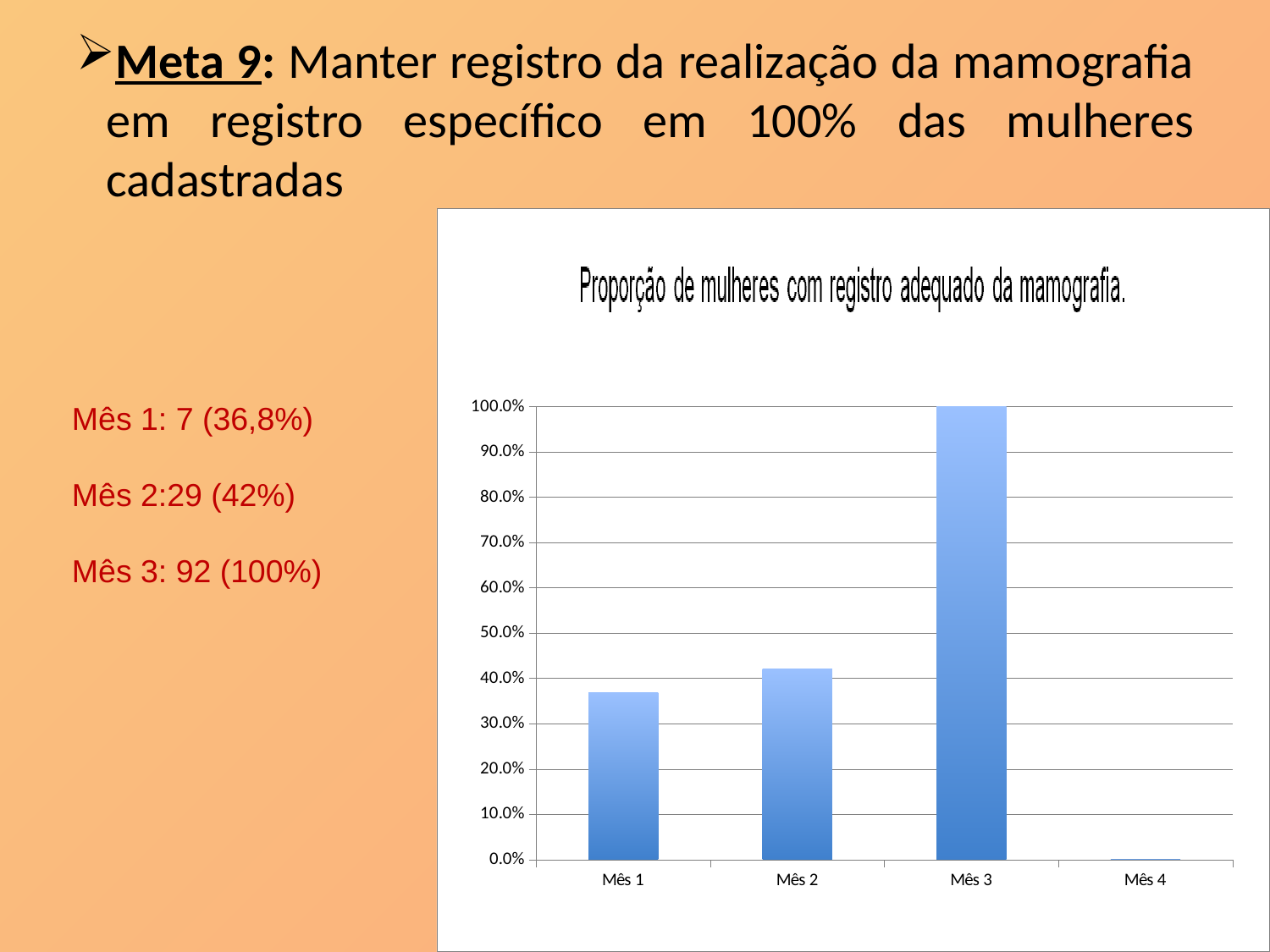
What is the value for Mês 3 in the chart? 100.0% Which is larger, the value for Mês 1 or the value for Mês 2? Mês 2 Is the value for Mês 1 greater or less than 40.0%? less What is the title of the chart? Proporção de mulheres com registro adequado da mamografia. Is the value for Mês 2 greater or less than 40.0%? greater What kind of chart is shown on the slide? bar chart Is the value for Mês 1 greater or less than 30.0%? greater Do the values rise or fall from Mês 1 to Mês 3? rise What is the highest tick value shown on the y axis of the chart? 100.0% Which category has the lowest value in the chart? Mês 4 Which category has the highest value in the chart? Mês 3 How many categories are shown on the x axis of the chart? 4